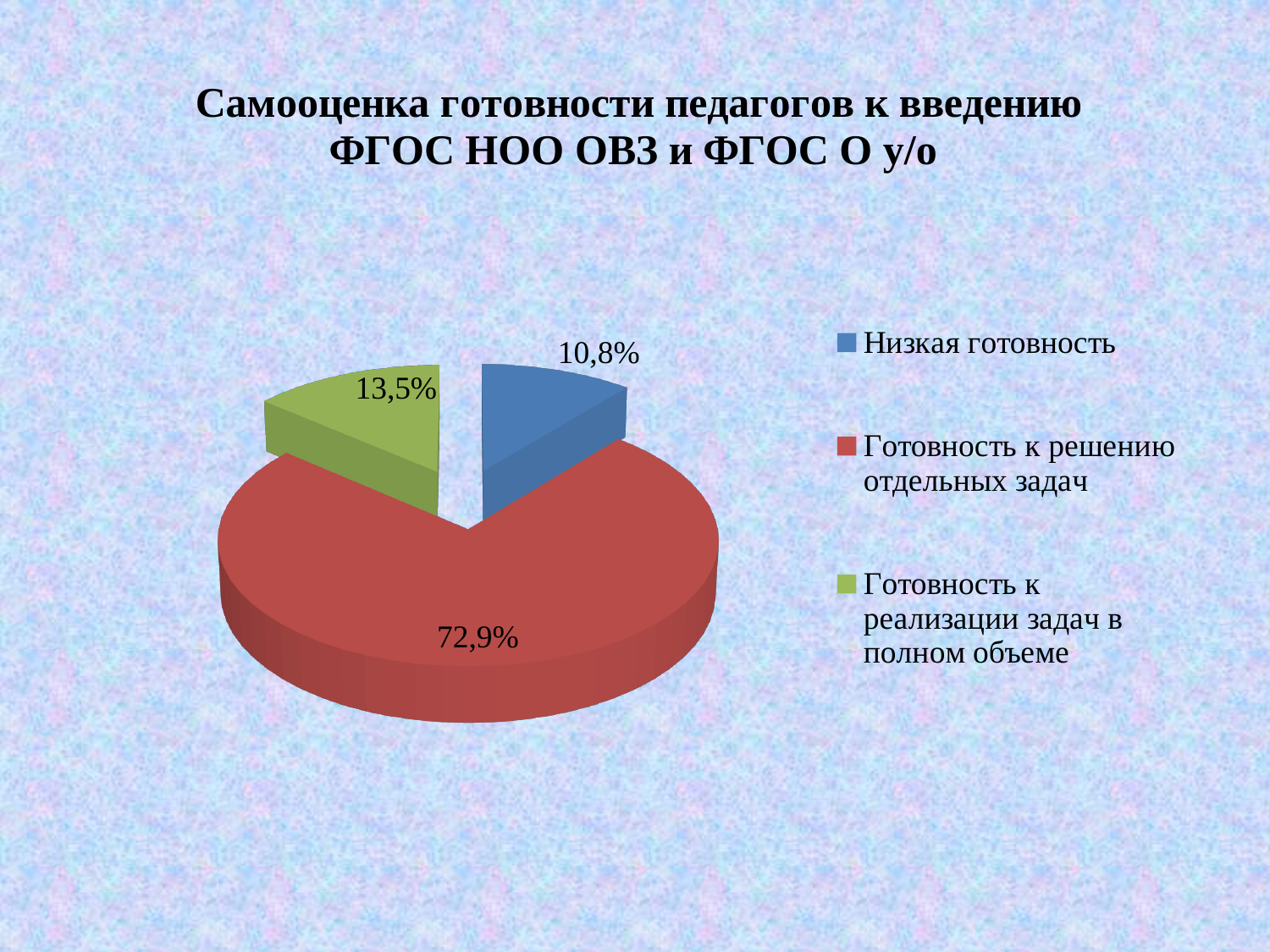
What colour is the slice for "Готовность к решению отдельных задач"? red What is the value for "Готовность к решению отдельных задач"? 72,9% Which category has the smallest share of the pie? Низкая готовность Which is larger: "Низкая готовность" or "Готовность к реализации задач в полном объеме"? Готовность к реализации задач в полном объеме What is the title of the chart? Самооценка готовности педагогов к введению ФГОС НОО ОВЗ и ФГОС О у/о Which category has the largest share of the pie? Готовность к решению отдельных задач What is the value for "Низкая готовность"? 10,8% What kind of chart is shown on the slide? pie chart How many slices does the pie chart have? 3 What is the difference between the values for "Готовность к реализации задач в полном объеме" and "Низкая готовность"? 2,7% What is the value for "Готовность к реализации задач в полном объеме"? 13,5% What is the difference between the values for "Готовность к решению отдельных задач" and "Готовность к реализации задач в полном объеме"? 59,4%